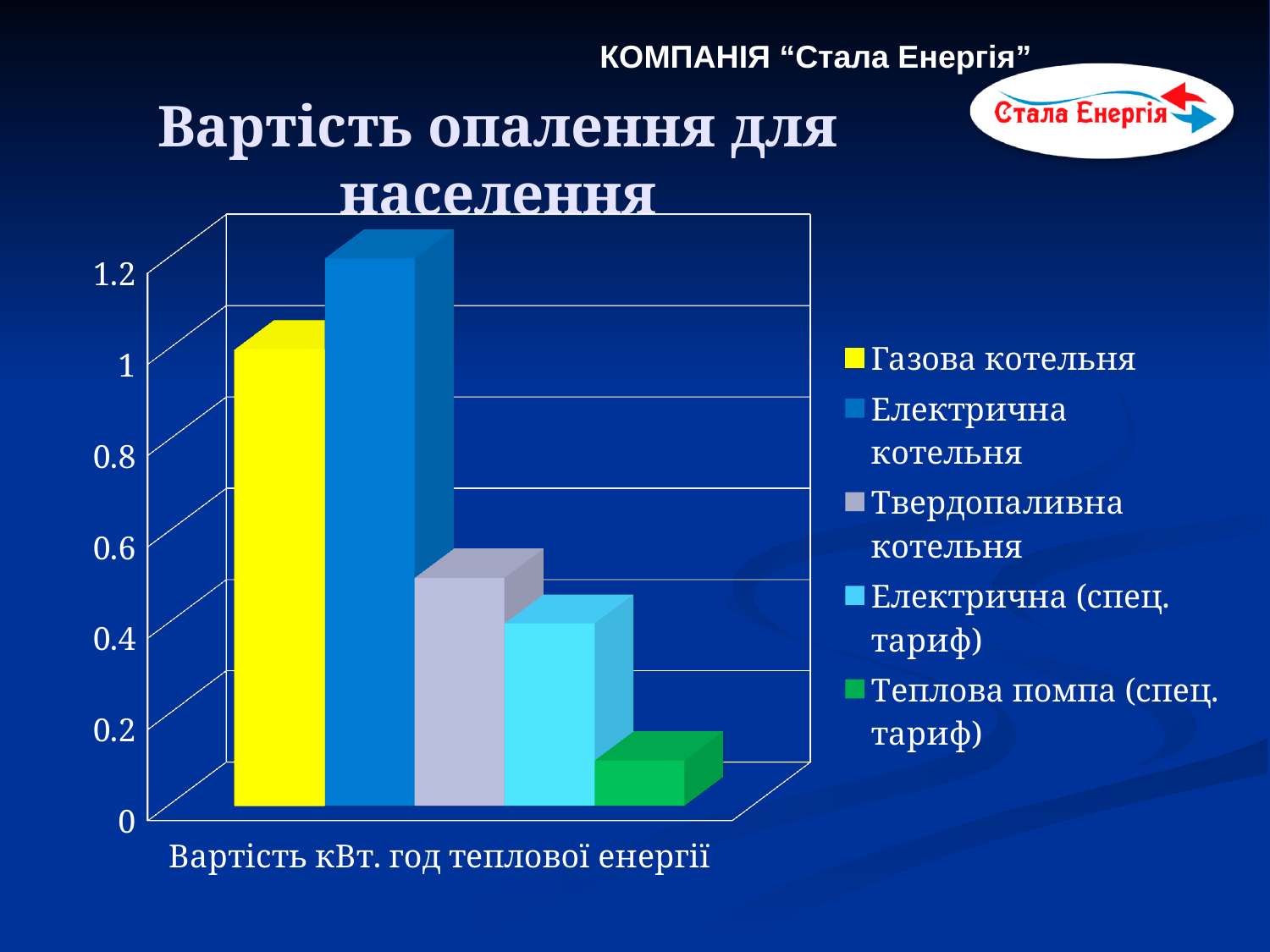
Is the value for Теплова помпа (спец. тариф) greater or less than 0.2? less What is the label shown on the category axis of the chart? Вартість кВт. год теплової енергії Is the value for Електрична (спец. тариф) greater or less than 0.6? less Is the value for Електрична котельня greater or less than 1? greater What is the title of the chart? Вартість опалення для населення Which series has the highest bar? Електрична котельня Which is larger, the value for Газова котельня or the value for Твердопаливна котельня? Газова котельня Which series has the lowest bar? Теплова помпа (спец. тариф) How many series does the legend list? 5 What kind of chart is shown on the slide? bar chart